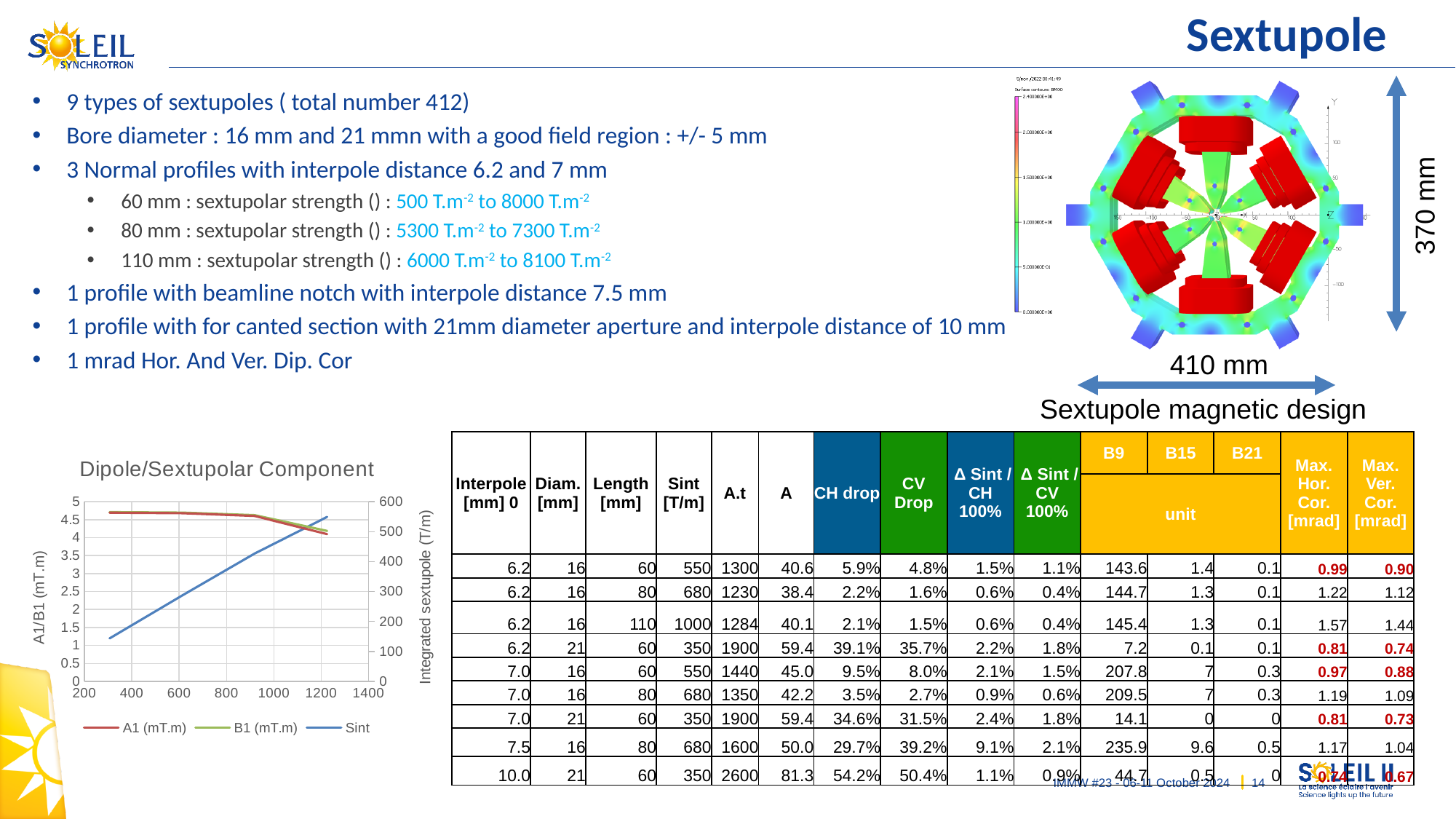
What kind of chart is the "Dipole/Sextupolar Component" chart? line chart What is the title of the chart on the slide? Dipole/Sextupolar Component In the "Dipole/Sextupolar Component" chart, is the A1 (mT.m) value at x = 400 greater or less than 4 on the left axis? greater In the "Dipole/Sextupolar Component" chart, is the Sint value at the left end of the line (around x = 300) greater or less than 200 on the right axis? less In the "Dipole/Sextupolar Component" chart, is the B1 (mT.m) value at the right end of the line (around x = 1200) greater or less than 4.5 on the left axis? less In the "Dipole/Sextupolar Component" chart, does the A1 (mT.m) series rise or fall overall from left to right? fall What is the maximum value shown on the right-hand axis of the "Dipole/Sextupolar Component" chart? 600 In the "Dipole/Sextupolar Component" chart, does the Sint series rise or fall as the x value increases? rise Which series in the "Dipole/Sextupolar Component" chart is drawn in blue? Sint How many series does the legend of the "Dipole/Sextupolar Component" chart list? 3